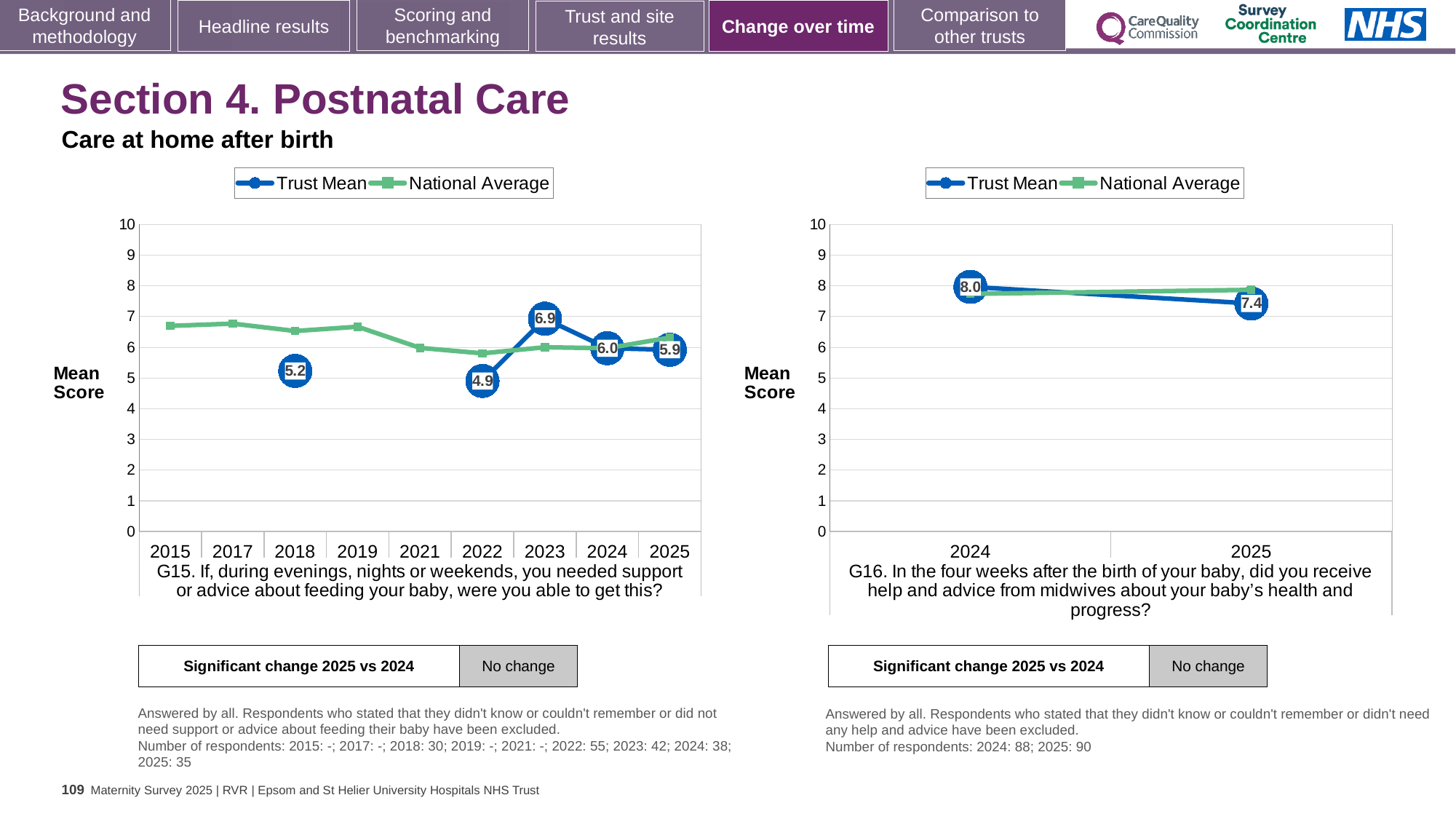
In the G15 chart on the left, what is the Trust Mean for 2023? 6.9 How many years are shown on the x axis of the G15 chart on the left? 9 In the G15 chart on the left, is the National Average for 2015 greater or less than 6? greater In the G16 chart on the right, what is the difference between the Trust Mean for 2024 and 2025? 0.6 In the G16 chart on the right, what is the Trust Mean for 2025? 7.4 In the G15 chart on the left, what is the Trust Mean for 2025? 5.9 In the G16 chart on the right, what is the Trust Mean for 2024? 8.0 How many series does the legend of the G16 chart on the right list? 2 In the G15 chart on the left, what is the Trust Mean for 2022? 4.9 In the G15 chart on the left, is the Trust Mean for 2018 or 2024 larger? 2024 In the G15 chart on the left, which year has the lowest Trust Mean? 2022 In the G15 chart on the left, which year has the highest Trust Mean? 2023